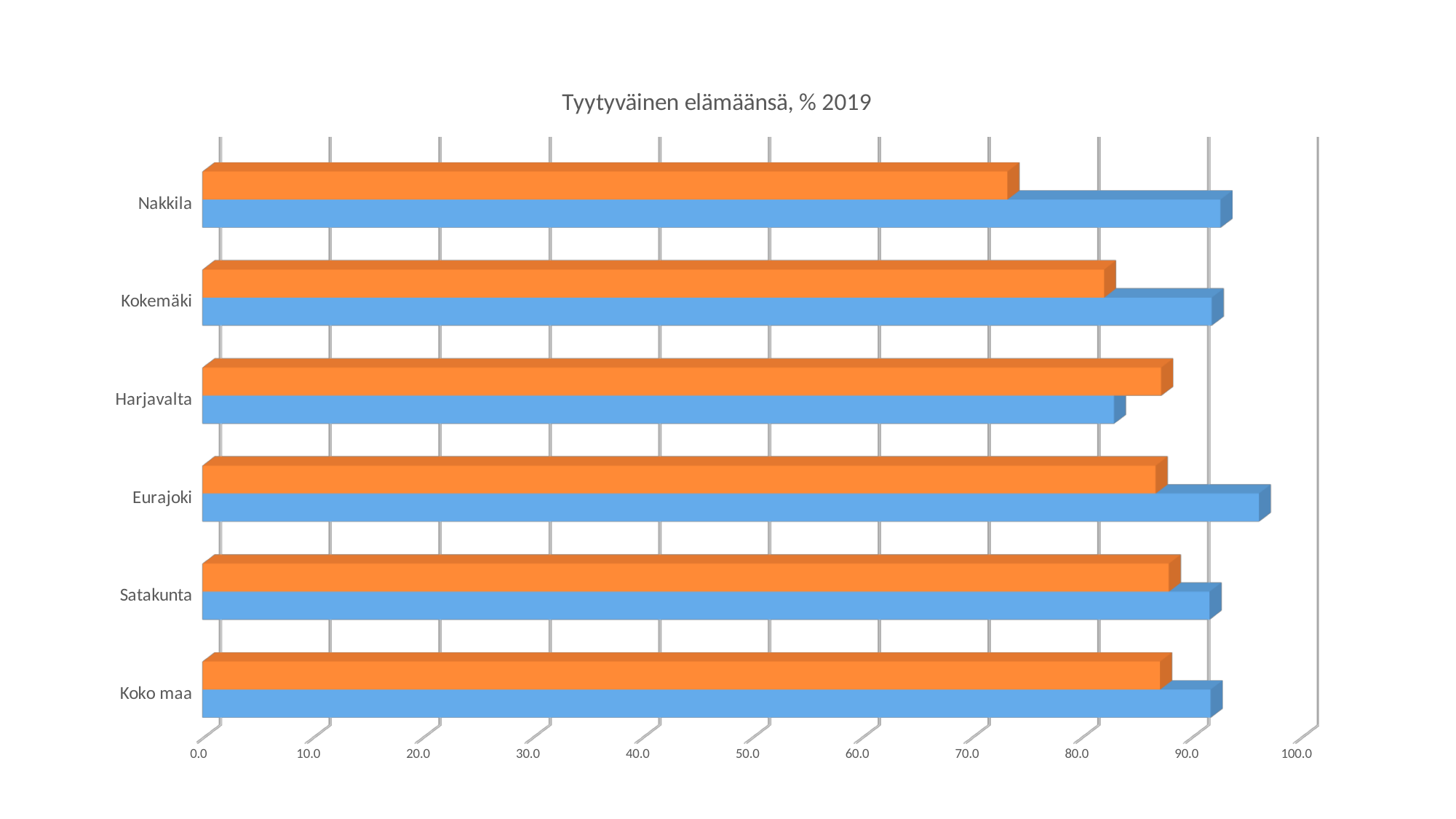
Is the value of the blue bar for Harjavalta greater or less than 90? less Which category has the longest blue bar? Eurajoki Is the value of the orange bar for Nakkila greater or less than 80? less What is the title of the chart? Tyytyväinen elämäänsä, % 2019 Which category has the shortest orange bar? Nakkila For Nakkila, which bar is longer, the orange one or the blue one? the blue one Which category has the shortest blue bar? Harjavalta Is the value of the blue bar for Eurajoki greater or less than 90? greater How many categories are shown on the vertical axis of the chart? 6 What kind of chart is shown on the slide? bar chart For Harjavalta, which bar is longer, the orange one or the blue one? the orange one